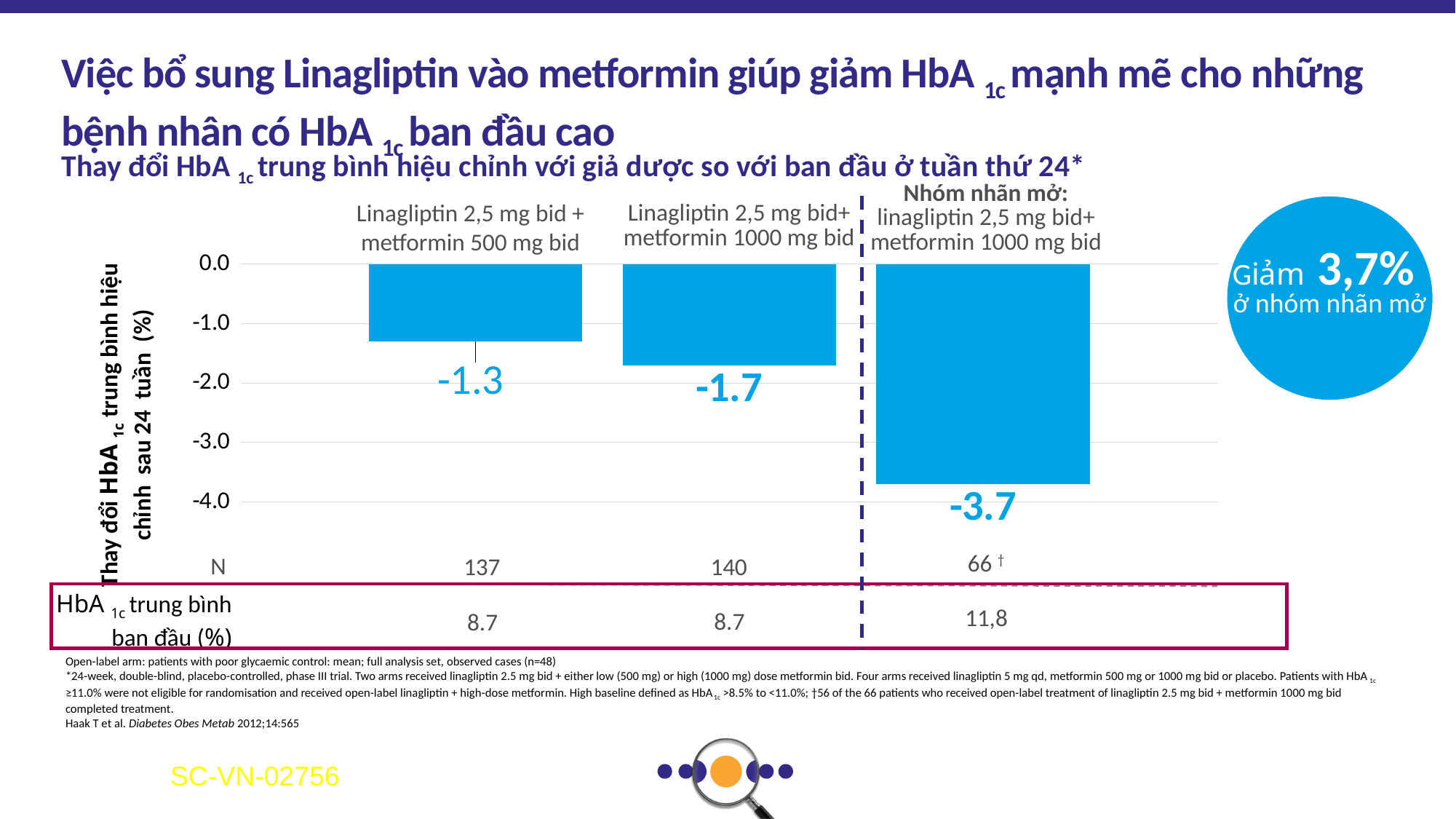
What is the label of the y-axis of the chart? Thay đổi HbA1c trung bình hiệu chỉnh sau 24 tuần (%) Which group shows the largest reduction in HbA1c? Nhóm nhãn mở: linagliptin 2,5 mg bid + metformin 1000 mg bid Which group shows the smallest reduction in HbA1c? Linagliptin 2,5 mg bid + metformin 500 mg bid What is the mean HbA1c change shown for the open-label group (Nhóm nhãn mở: linagliptin 2,5 mg bid + metformin 1000 mg bid)? -3.7 What is the placebo-adjusted mean HbA1c change for Linagliptin 2,5 mg bid + metformin 1000 mg bid? -1.7 What type of chart is shown on the slide? Bar chart What is the placebo-adjusted mean HbA1c change for Linagliptin 2,5 mg bid + metformin 500 mg bid? -1.3 Which group has a larger HbA1c reduction: Linagliptin 2,5 mg bid + metformin 500 mg bid or Linagliptin 2,5 mg bid + metformin 1000 mg bid? Linagliptin 2,5 mg bid + metformin 1000 mg bid How many treatment groups (bars) are shown in the chart? 3 What is the difference between the HbA1c change in the open-label group (-3.7) and the Linagliptin 2,5 mg bid + metformin 1000 mg bid group (-1.7)? 2.0 What is the baseline mean HbA1c (%) for the open-label group? 11,8 What is the N (number of patients) for the Linagliptin 2,5 mg bid + metformin 500 mg bid group? 137